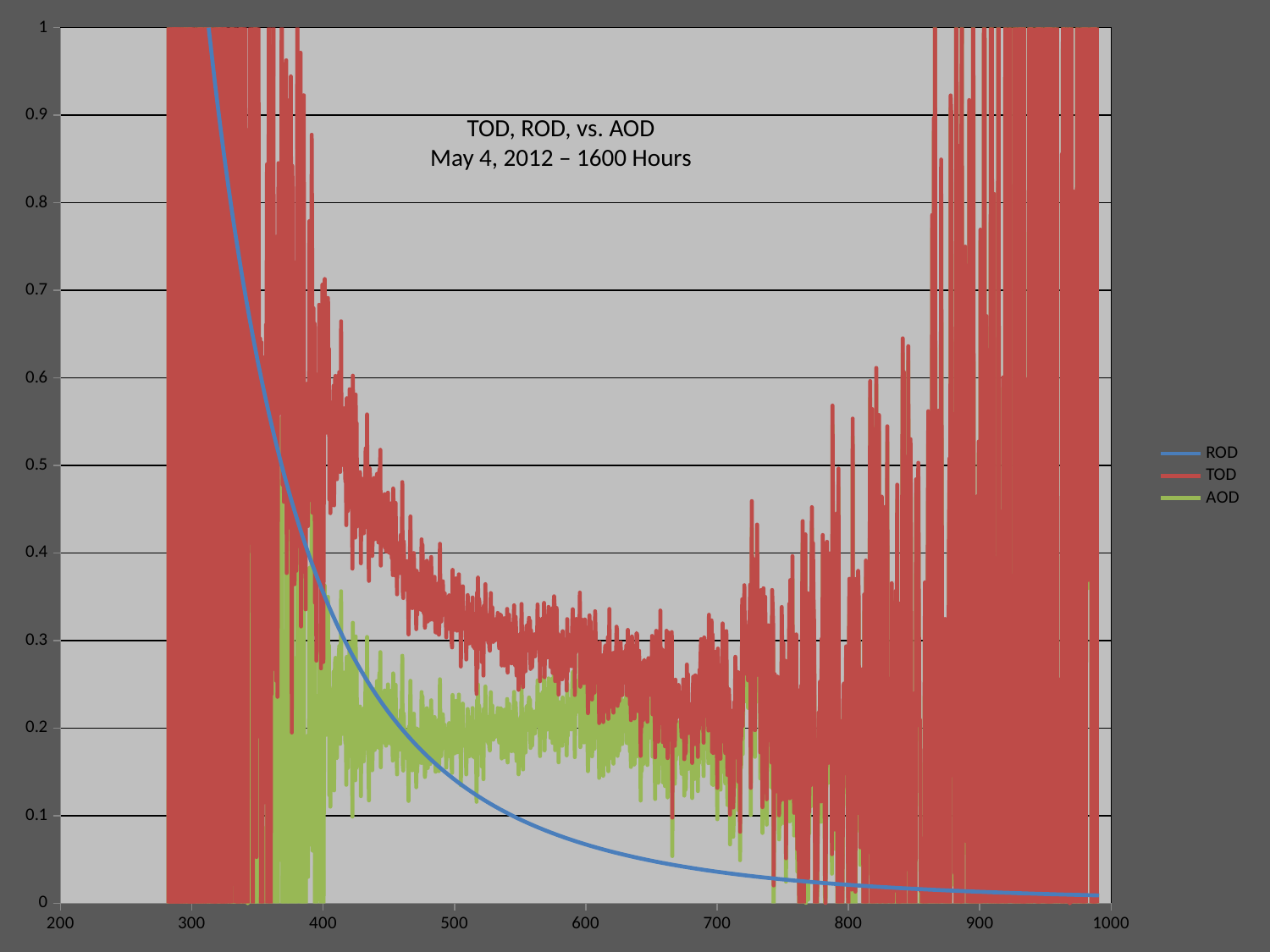
Is the ROD value at x = 400 greater or less than 0.3? greater Does the TOD series generally rise or fall between x = 700 and x = 900? Rise Does the ROD series rise or fall as the x-axis value increases? Fall At x = 600, which series has the lower value, ROD or AOD? ROD What kind of chart is shown on the slide? Line chart Is the ROD value at x = 500 greater or less than 0.2? less Is the ROD value at x = 800 greater or less than 0.1? less How many series does the legend list? 3 At x = 500, which series has the higher value, TOD or AOD? TOD Which colour is used for the AOD series in the legend? Green What is the title of the chart? TOD, ROD, vs. AOD May 4, 2012 – 1600 Hours